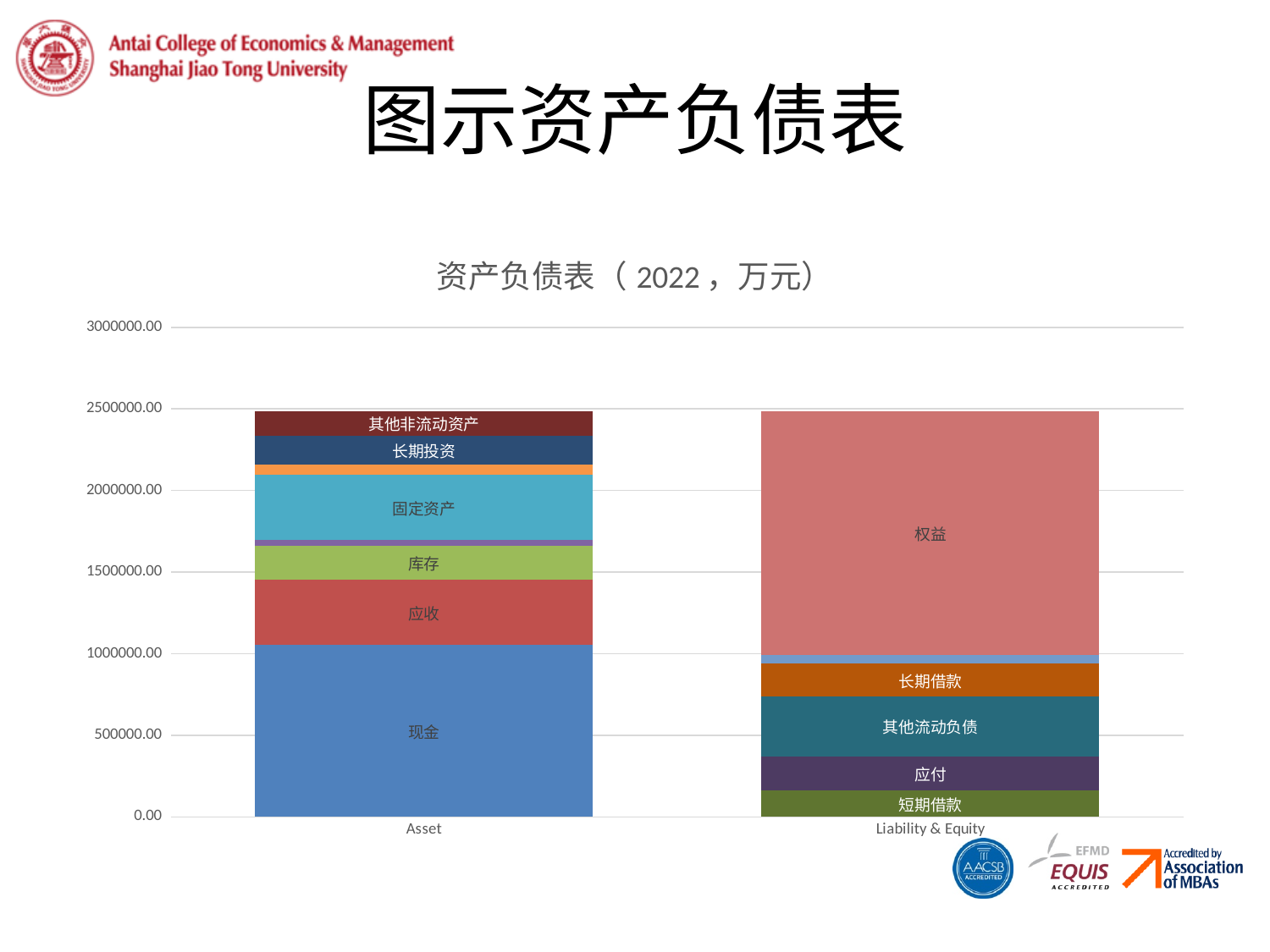
How many categories are shown on the x axis of the chart? 2 Which is larger in the Asset bar, 现金 or 应收? 现金 Which is larger in the Liability & Equity bar, 其他流动负债 or 短期借款? 其他流动负债 Is the value of the 现金 segment greater or less than 500000.00? greater What kind of chart is shown on the slide? stacked bar chart Which is larger in the Liability & Equity bar, 权益 or 长期借款? 权益 Which segment is the largest in the Liability & Equity bar? 权益 What is the title of the chart? 资产负债表（2022，万元） Which segment is the largest in the Asset bar? 现金 What is the highest value shown on the y axis of the chart? 3000000.00 Is the total height of the Asset bar greater or less than 2000000.00? greater